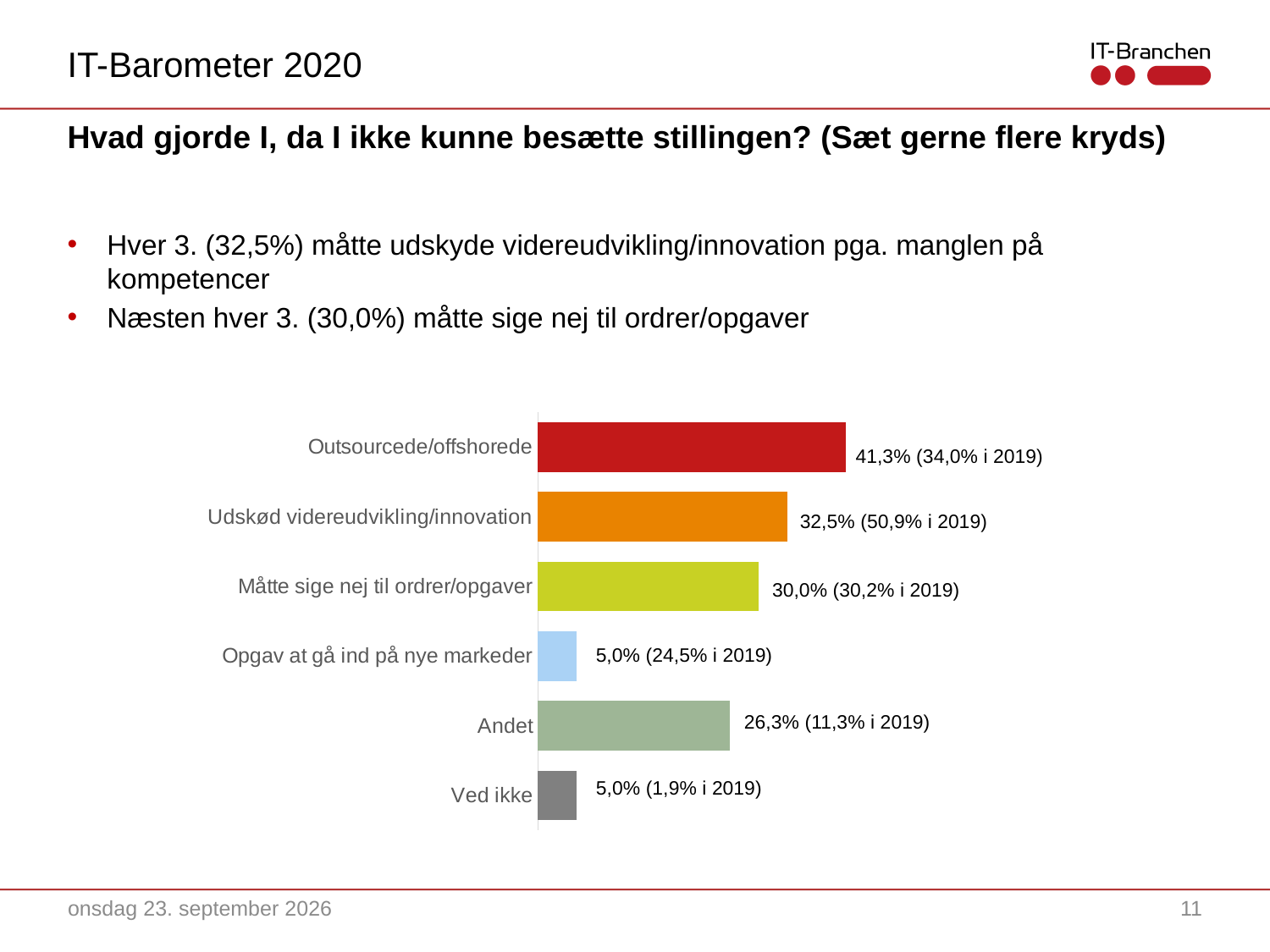
Which category has the highest value in the chart? Outsourcede/offshorede Which category had the highest 2019 value shown in parentheses? Udskød videreudvikling/innovation Which is larger, the value for Andet or the value for Opgav at gå ind på nye markeder? Andet What was the 2019 value shown in parentheses for Ved ikke? 1,9% What is the difference between the value for Måtte sige nej til ordrer/opgaver and the value for Andet? 3,7 percentage points What is the difference between the values for Outsourcede/offshorede and Udskød videreudvikling/innovation? 8,8 percentage points What kind of chart is shown on the slide? Bar chart What is the value shown for Outsourcede/offshorede? 41,3% What was the 2019 value shown in parentheses for Opgav at gå ind på nye markeder? 24,5% What is the value shown for Udskød videreudvikling/innovation? 32,5% What is the value shown for Andet? 26,3% How many categories are shown in the chart? 6